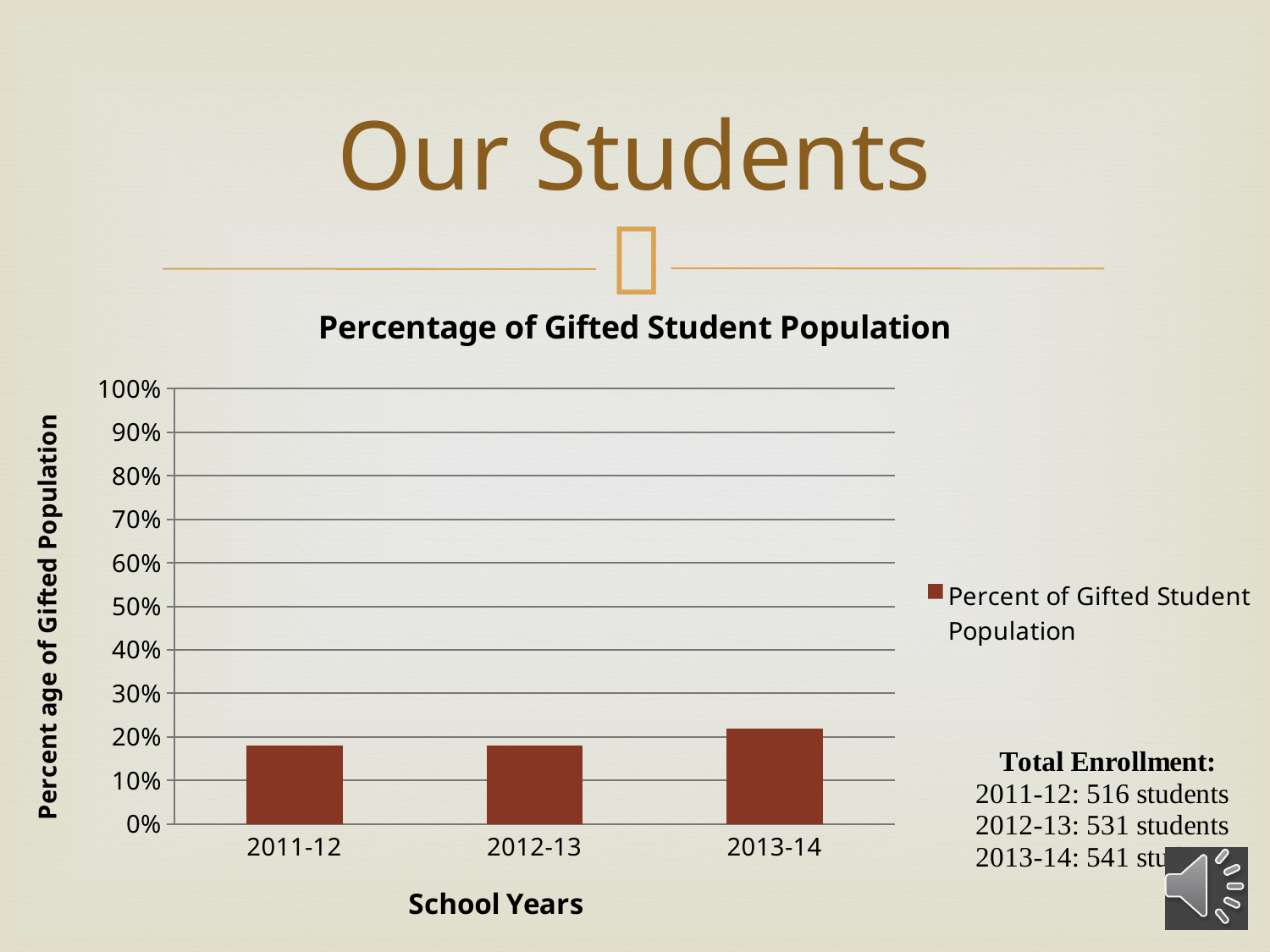
What kind of chart is shown on the slide? bar chart Is the value for 2011-12 greater or less than 10%? greater How many series does the chart's legend list? 1 Is the value for 2012-13 greater or less than 30%? less What is the x-axis title of the chart? School Years Is the value for 2013-14 greater or less than 30%? less Which is larger, the value for 2013-14 or the value for 2011-12? 2013-14 Does the percentage of gifted student population rise or fall from 2011-12 to 2013-14? rise How many school years are shown on the x axis of the chart? 3 Which school year has the highest percentage of gifted student population? 2013-14 What is the title of the chart? Percentage of Gifted Student Population